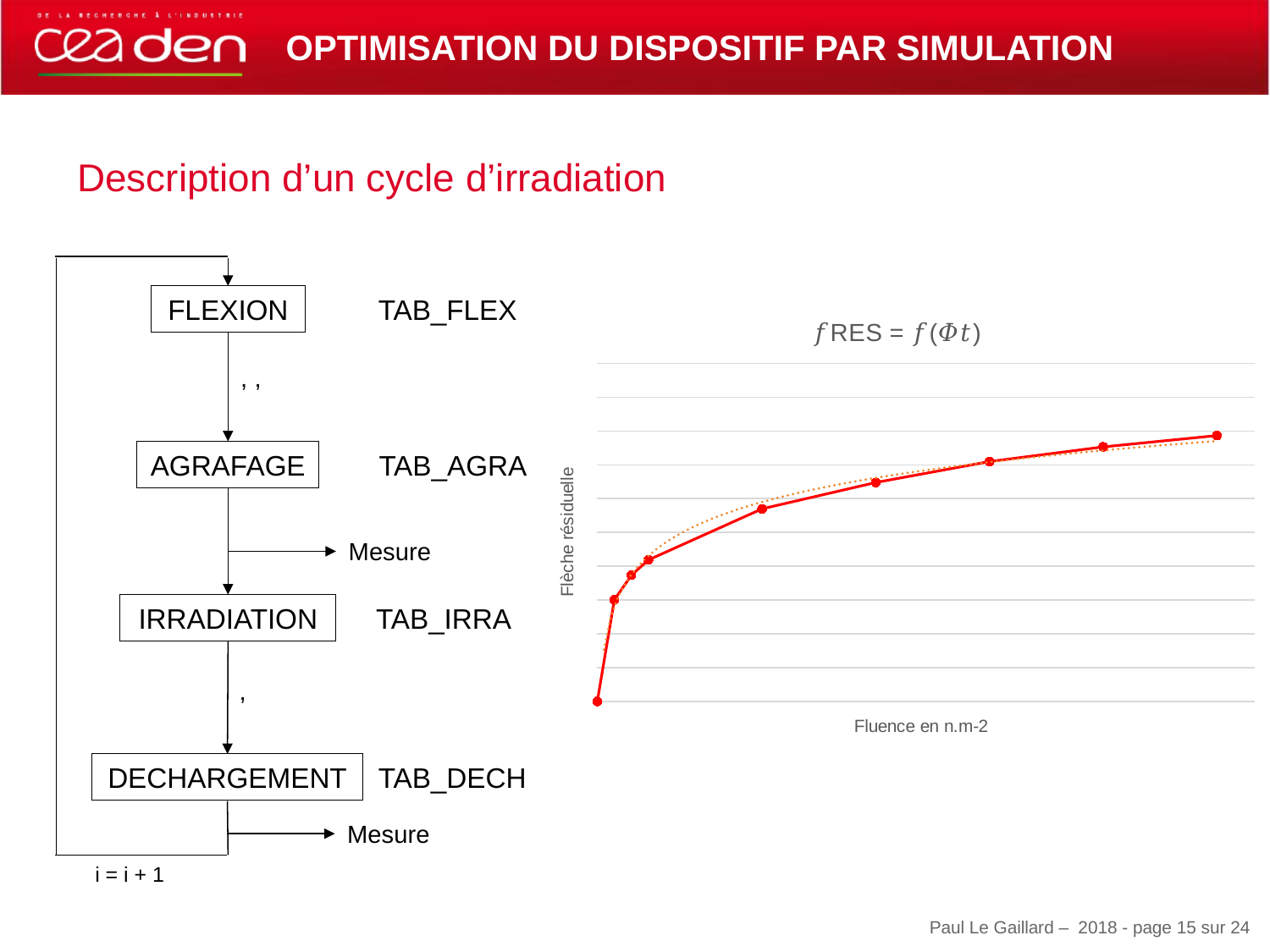
What kind of chart is shown on the right of the slide? line chart Which point of the red line is the highest, the leftmost or the rightmost? the rightmost How many red data points are plotted on the line chart? 9 What is the title of the chart? fRES = f(Φt) Which point of the red line is the lowest, the leftmost or the rightmost? the leftmost What is the label of the x axis of the chart? Fluence en n.m-2 Do the values of the red line rise or fall as fluence increases along the x axis? rise Is the first (leftmost) point of the red line higher or lower than the last (rightmost) point? lower